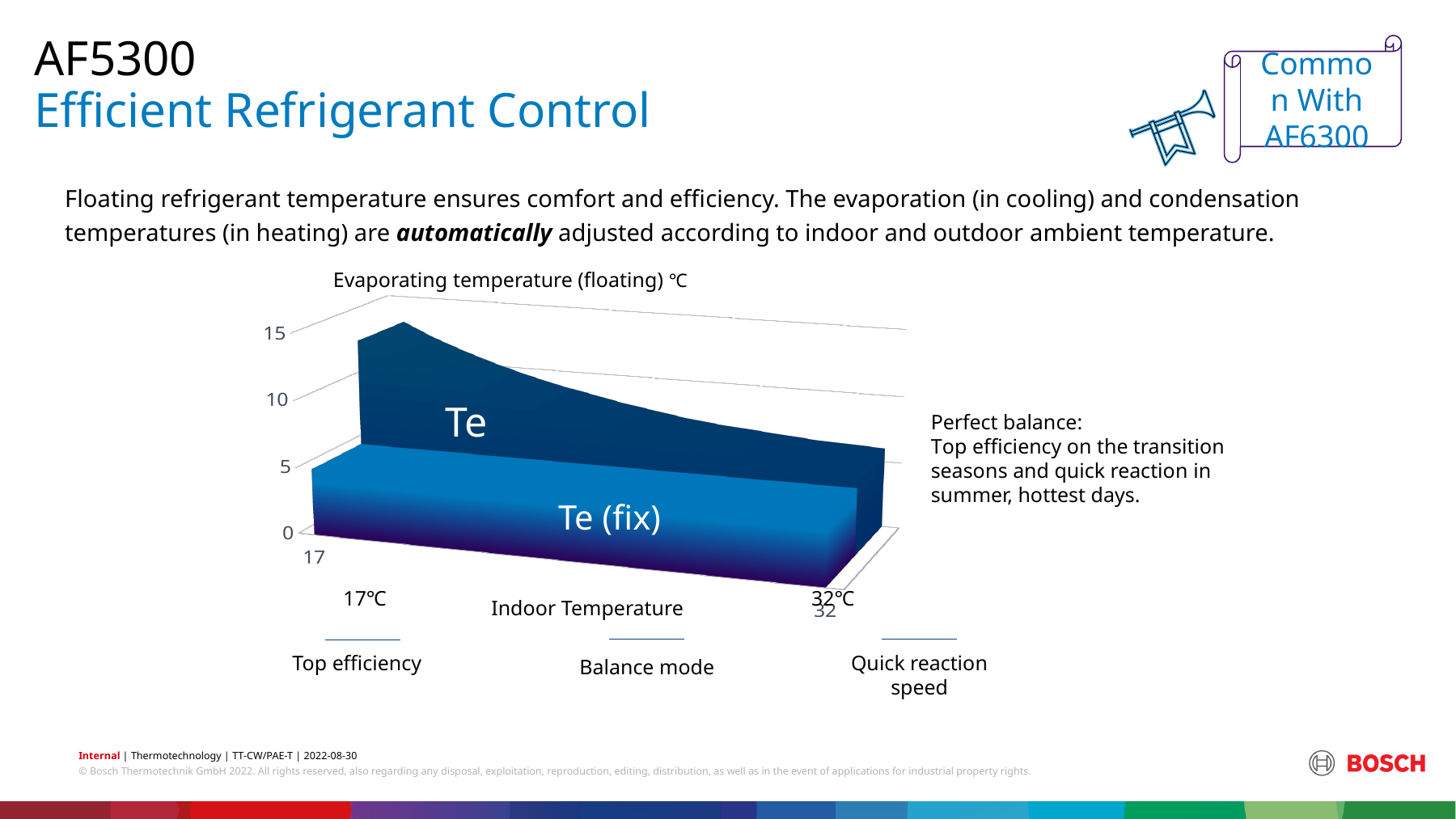
What are the names of the two series shown in the chart? Te and Te (fix) What is the label of the horizontal axis of the chart? Indoor Temperature Is the value of Te at an indoor temperature of 17℃ greater or less than 10? greater At an indoor temperature of 17℃, which series has the larger value, Te or Te (fix)? Te Is the value of Te (fix) greater or less than 10? less What kind of chart is shown on the slide? area chart What is the title of the chart? Evaporating temperature (floating) ℃ How many series are plotted in the chart? 2 Is the value of Te at an indoor temperature of 32℃ greater or less than 10? less Does the Te (floating) series rise or fall as indoor temperature increases from 17℃ to 32℃? fall